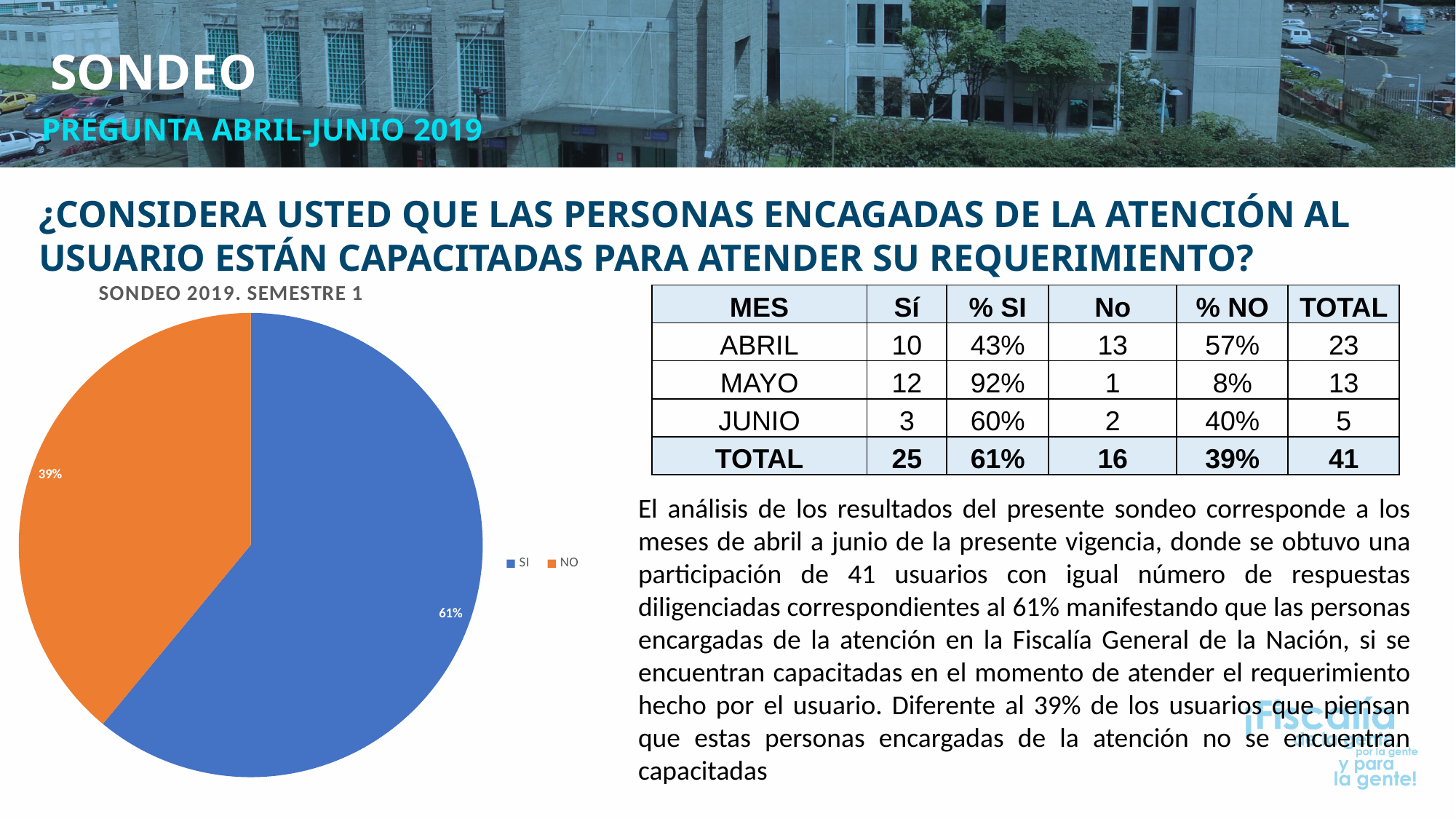
What colour is the SI slice in the pie chart? blue Is the share of the NO slice greater or less than 50%? less How many entries does the legend of the pie chart list? 2 What share of the pie does the NO slice represent? 39% Which is larger in the pie chart, SI or NO? SI What is the difference in percentage points between the SI and NO slices? 22% What share of the pie does the SI slice represent? 61% What is the title of the pie chart? SONDEO 2019. SEMESTRE 1 Which slice of the pie chart is the largest? SI What kind of chart is shown on the slide? pie chart Which slice of the pie chart is the smallest? NO How many slices does the pie chart have? 2